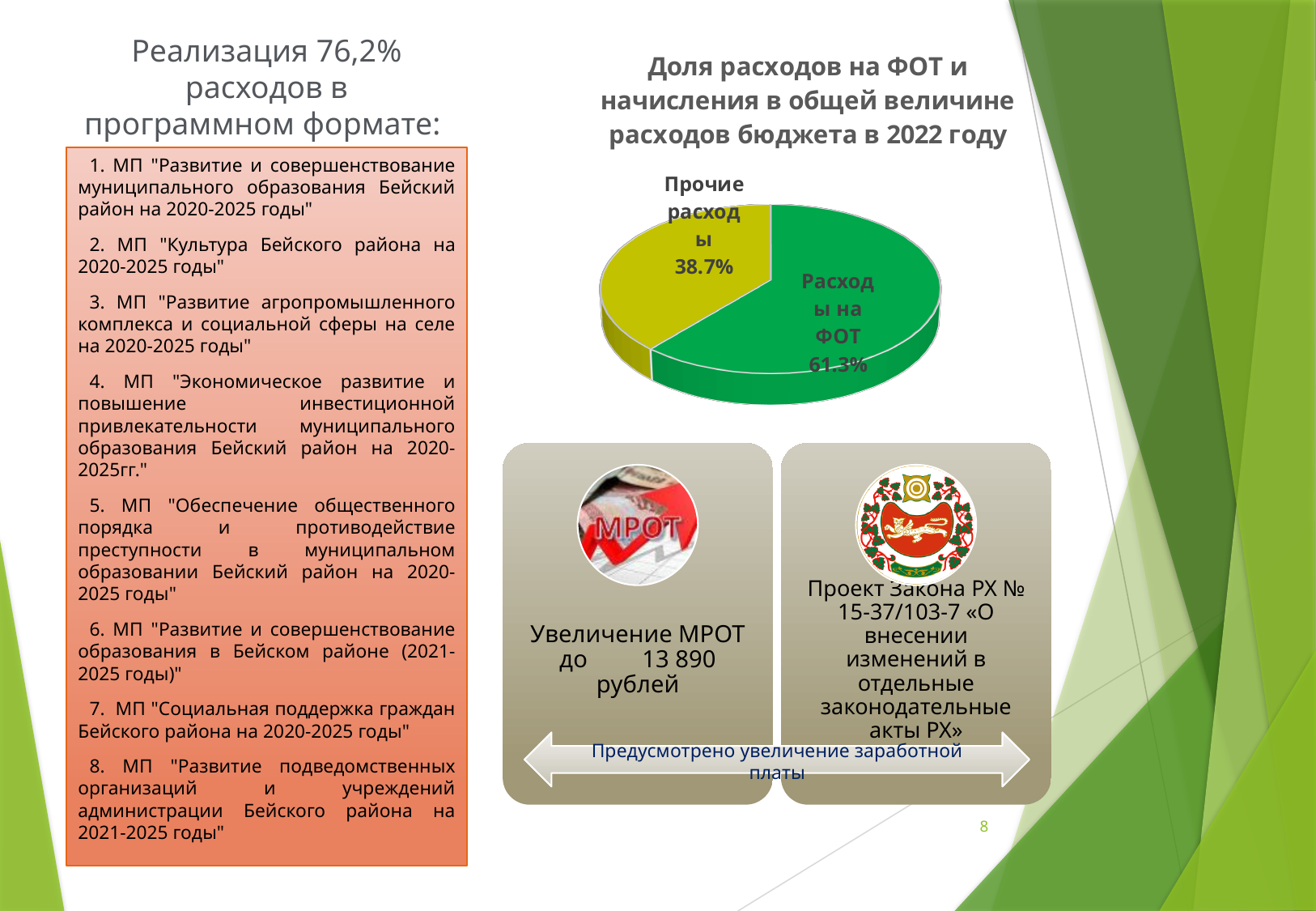
How many slices does the pie chart have? 2 Is the share of "Расходы на ФОТ" in the pie chart greater or less than 50%? greater What share of the pie chart is labelled "Расходы на ФОТ"? 61.3% Which slice of the pie chart is the largest? Расходы на ФОТ What is the title of the pie chart? Доля расходов на ФОТ и начисления в общей величине расходов бюджета в 2022 году By how many percentage points does the "Расходы на ФОТ" slice exceed the "Прочие расходы" slice? 22.6 Which is larger in the pie chart: "Расходы на ФОТ" or "Прочие расходы"? Расходы на ФОТ What share of the pie chart is labelled "Прочие расходы"? 38.7% What is the total of the two slices shown in the pie chart? 100% Which slice of the pie chart is the smallest? Прочие расходы What colour is the "Расходы на ФОТ" slice of the pie chart? Green What type of chart is shown on the slide? Pie chart